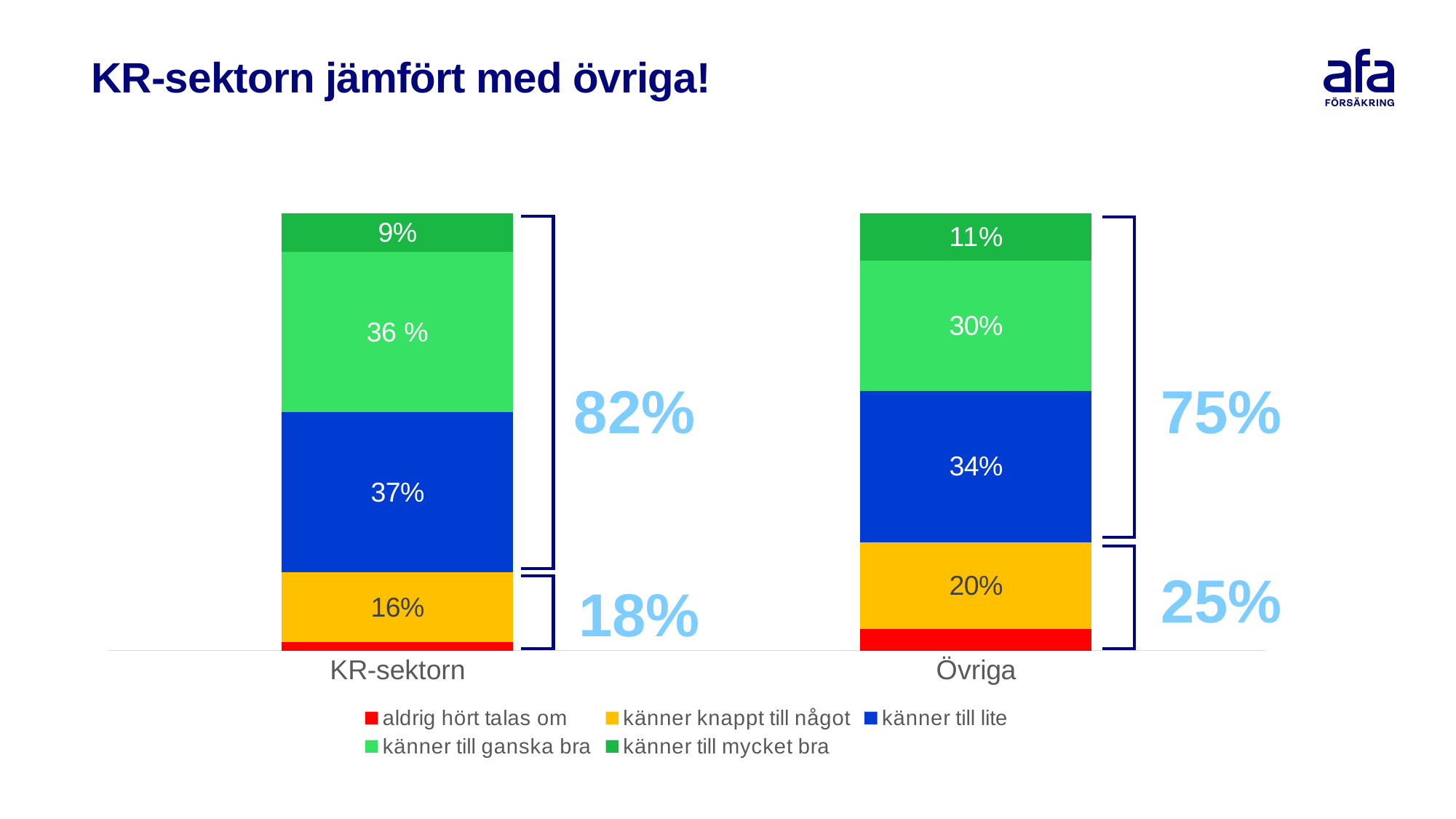
What kind of chart is shown on the slide? Stacked bar chart What is the value of 'känner till lite' for KR-sektorn? 37% How many categories are shown on the x axis of the chart? 2 Which category has the larger value for 'känner till ganska bra', KR-sektorn or Övriga? KR-sektorn What combined percentage is shown by the lower bracket next to the KR-sektorn bar? 18% What is the value of 'känner knappt till något' for KR-sektorn? 16% What is the difference between the 'känner till lite' values for KR-sektorn (37%) and Övriga (34%)? 3 percentage points What is the value of 'känner till mycket bra' for Övriga? 11% What is the value of 'känner till ganska bra' for Övriga? 30% What is the title of the slide? KR-sektorn jämfört med övriga! How many series does the legend list? 5 What combined percentage is shown by the upper bracket next to the Övriga bar? 75%